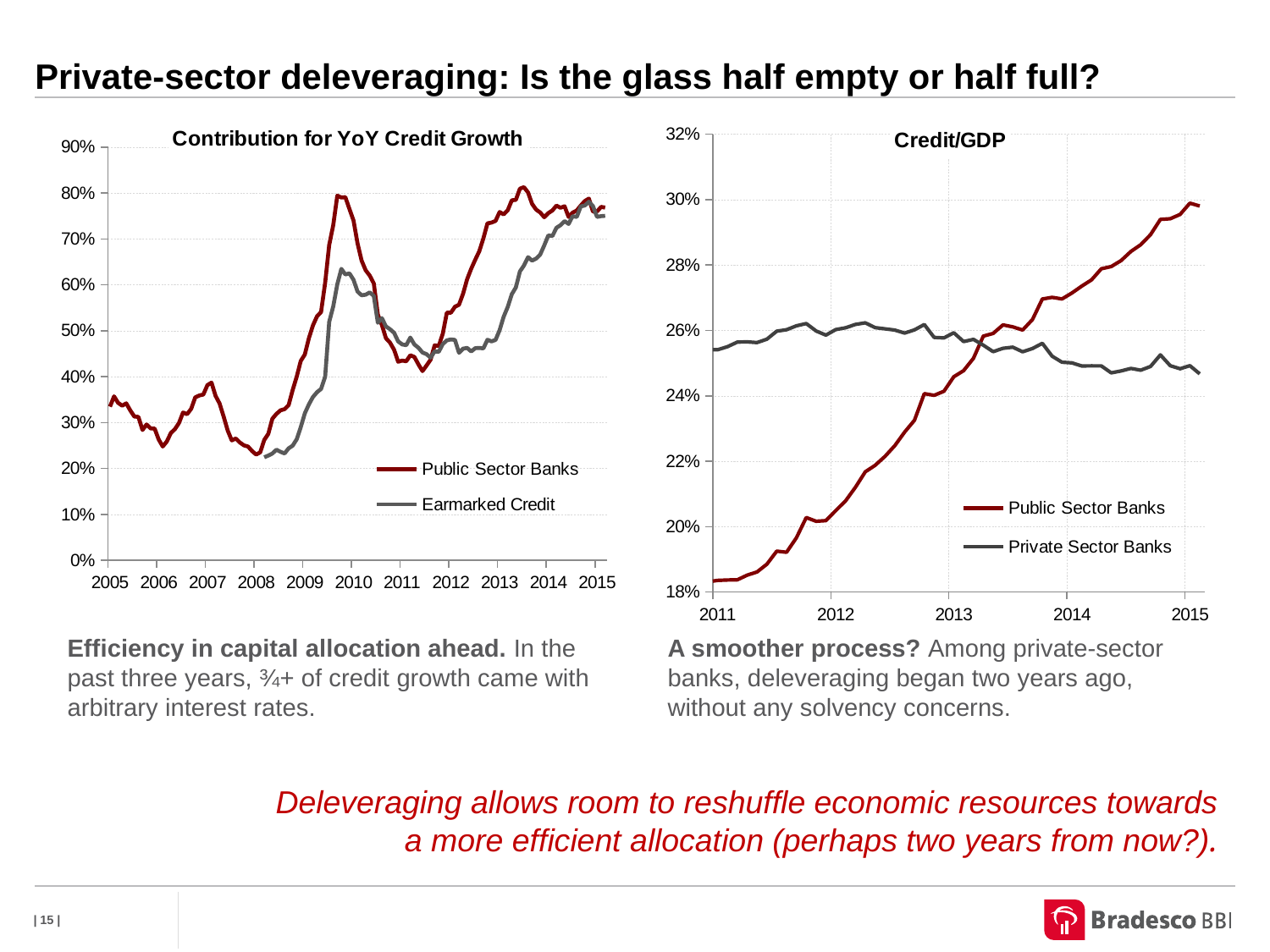
In the "Credit/GDP" chart, does the Public Sector Banks line rise or fall from 2011 to 2015? rise What kind of chart is the left chart titled "Contribution for YoY Credit Growth"? line chart In the "Credit/GDP" chart, which series has the higher value at 2015, Public Sector Banks or Private Sector Banks? Public Sector Banks In the "Contribution for YoY Credit Growth" chart, is the peak value of Public Sector Banks around 2009-2010 greater or less than 70%? greater In the "Credit/GDP" chart, which series is shown in red? Public Sector Banks In the "Credit/GDP" chart, is the value for Private Sector Banks at the start of 2011 greater or less than 24%? greater In the "Contribution for YoY Credit Growth" chart, which series is shown in grey? Earmarked Credit In the "Credit/GDP" chart, is the value for Public Sector Banks at the start of 2011 greater or less than 20%? less What kind of chart is the right chart titled "Credit/GDP"? line chart How many series does the legend of the "Credit/GDP" chart list? 2